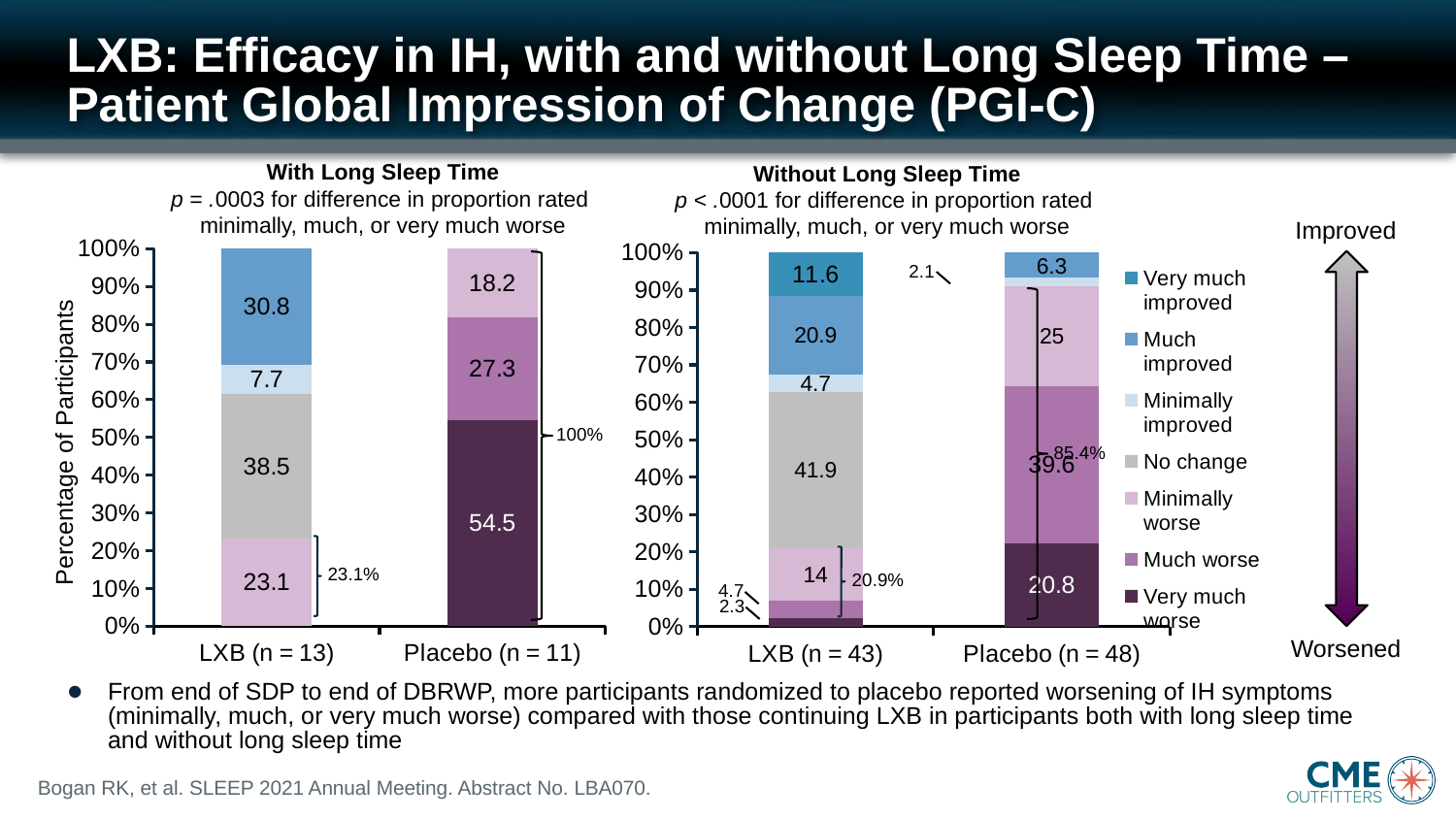
In the With Long Sleep Time chart, what percentage of LXB (n = 13) participants were rated Much improved? 30.8 In the With Long Sleep Time chart, what percentage of Placebo (n = 11) participants were rated Very much worse? 54.5 In the Without Long Sleep Time chart, what percentage of Placebo (n = 48) participants were rated Much worse? 39.6 In the Without Long Sleep Time chart, which segment of the LXB (n = 43) bar is the largest? No change How many treatment groups are shown in the With Long Sleep Time chart? 2 In the With Long Sleep Time chart, what is the difference between the No change and Minimally worse percentages for LXB (n = 13)? 15.4 In the Without Long Sleep Time chart, which is larger: the Very much improved percentage for LXB (n = 43) or the Much improved percentage for Placebo (n = 48)? Very much improved for LXB (n = 43) What p-value is reported for the With Long Sleep Time chart? p = .0003 In the Without Long Sleep Time chart, what is the combined percentage of Placebo (n = 48) participants rated minimally, much, or very much worse? 85.4% In the Without Long Sleep Time chart, what percentage of LXB (n = 43) participants reported No change? 41.9 How many entries does the legend list? 7 What kind of chart is used on this slide? Stacked bar chart